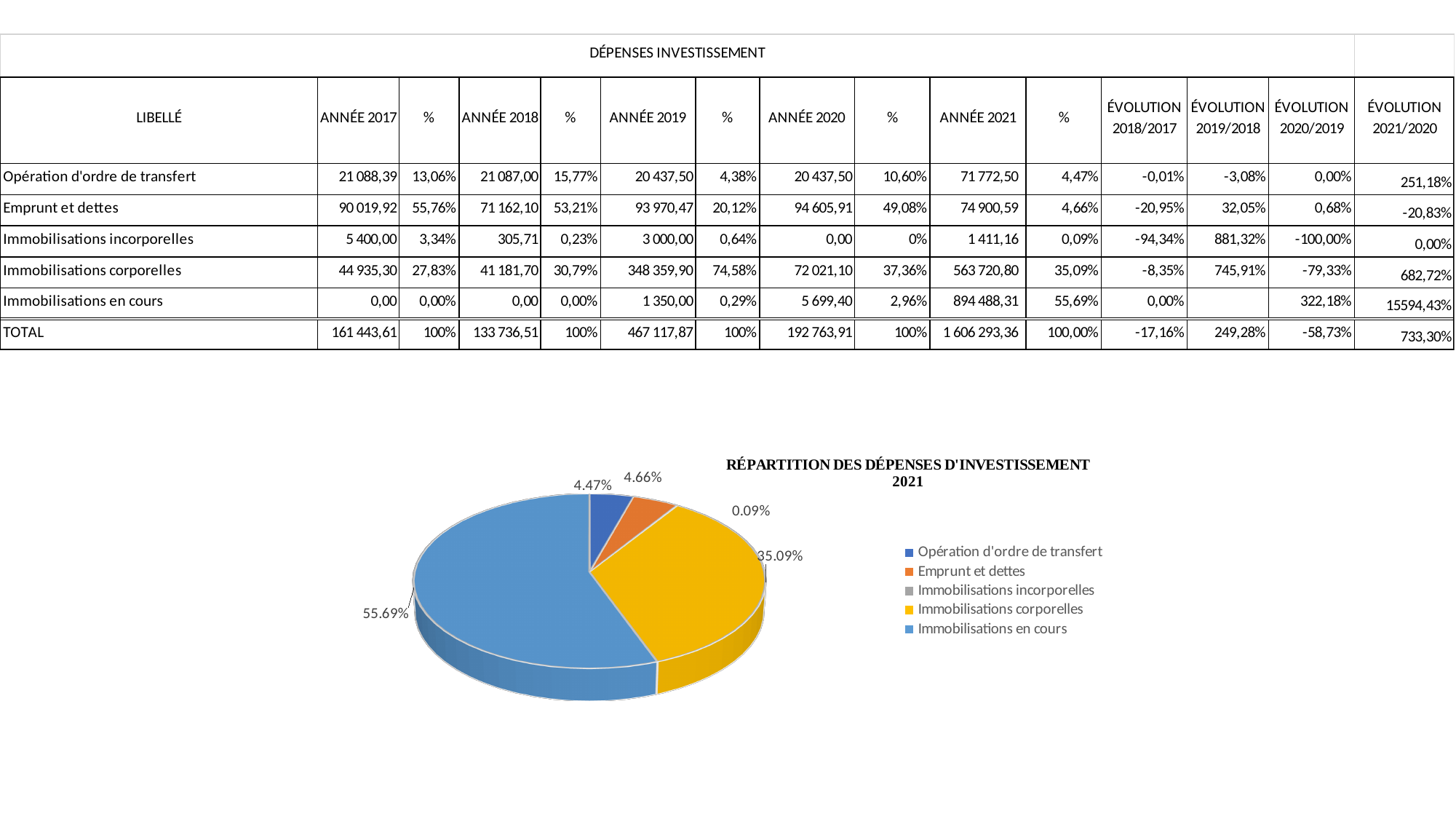
What kind of chart is shown on the slide? Pie chart Which category has the largest slice in the pie chart? Immobilisations en cours What is the difference between the shares of Immobilisations en cours and Immobilisations corporelles in the pie chart? 20.60% What share of the pie chart does Immobilisations en cours represent? 55.69% Which category has the smallest slice in the pie chart? Immobilisations incorporelles What share of the pie chart does Immobilisations corporelles represent? 35.09% In the pie chart, which is larger: Immobilisations en cours or Immobilisations corporelles? Immobilisations en cours How many categories does the pie chart's legend list? 5 What is the value shown for Emprunt et dettes in the pie chart? 4.66% What is the title of the pie chart? RÉPARTITION DES DÉPENSES D'INVESTISSEMENT 2021 What is the value shown for Opération d'ordre de transfert in the pie chart? 4.47% What is the value shown for Immobilisations incorporelles in the pie chart? 0.09%